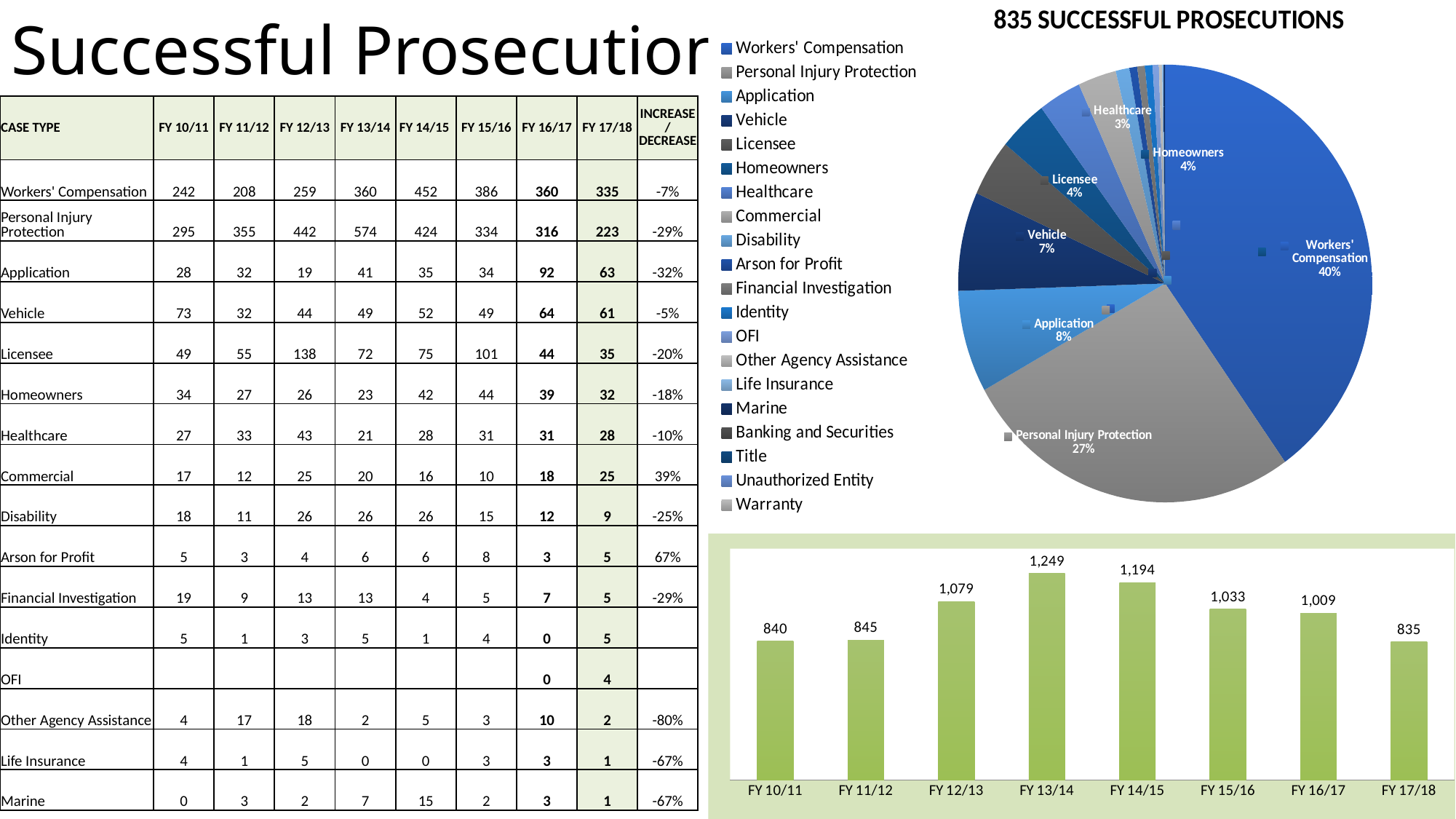
How many entries does the legend of the pie chart titled '835 SUCCESSFUL PROSECUTIONS' list? 20 In the bar chart at the bottom right, which fiscal year has the lowest value? FY 17/18 In the bar chart at the bottom right, what is the value for FY 17/18? 835 How many bars are in the bar chart at the bottom right? 8 In the pie chart titled '835 SUCCESSFUL PROSECUTIONS', what share does Workers' Compensation have? 40% In the pie chart titled '835 SUCCESSFUL PROSECUTIONS', what share does Personal Injury Protection have? 27% In the bar chart at the bottom right, which is larger, the value for FY 12/13 or the value for FY 15/16? FY 12/13 In the pie chart titled '835 SUCCESSFUL PROSECUTIONS', which category has the largest slice? Workers' Compensation In the bar chart at the bottom right, which fiscal year has the highest value? FY 13/14 In the bar chart at the bottom right, what is the difference between the values for FY 13/14 and FY 14/15? 55 In the bar chart at the bottom right, what is the value for FY 13/14? 1,249 What kind of chart is shown at the bottom right of the slide? Bar chart